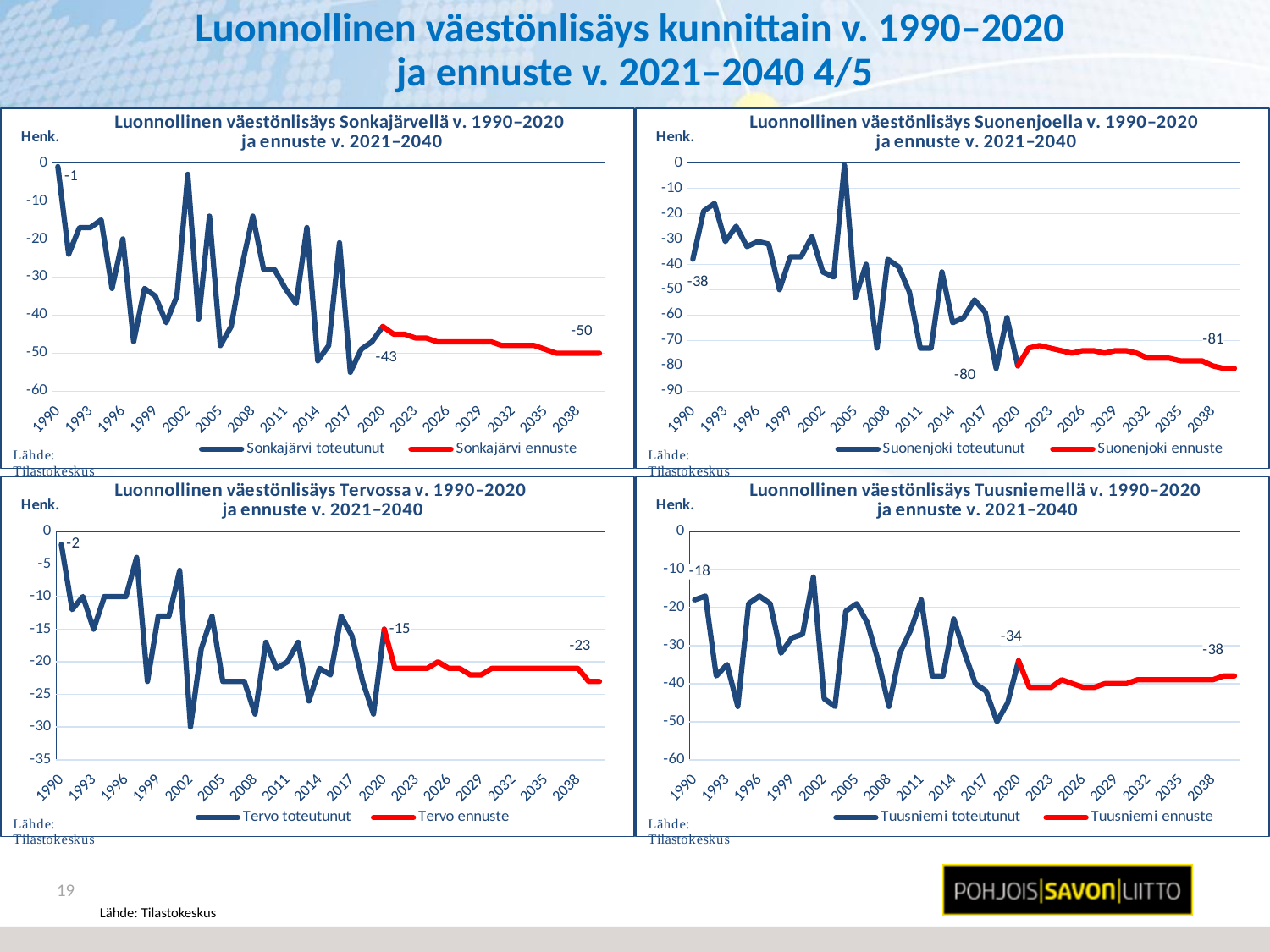
In the Tuusniemi chart (bottom right), which labelled value is larger: 1990 (-18) or 2020 (-34)? 1990 (-18) What kind of chart is the Tervo chart (bottom left)? Line chart In the Suonenjoki chart (top right), what colour is the forecast (ennuste) line? Red How many series does the legend of the Sonkajärvi chart (top left) list? 2 In the Sonkajärvi chart (top left), what is the labelled value for 1990? -1 In the Suonenjoki chart (top right), what is the labelled value for 1990? -38 In the Tervo chart (bottom left), what is the labelled value for 2020? -15 In the Sonkajärvi chart (top left), what is the labelled value at the end of the forecast in 2040? -50 In the Tervo chart (bottom left), what is the difference between the labelled 1990 value (-2) and the labelled 2040 value (-23)? 21 In the Suonenjoki chart (top right), what is the labelled value for 2020? -80 In the Tuusniemi chart (bottom right), what is the labelled value for 2040? -38 In the Suonenjoki chart (top right), is the value for 2008 greater or less than -60? greater